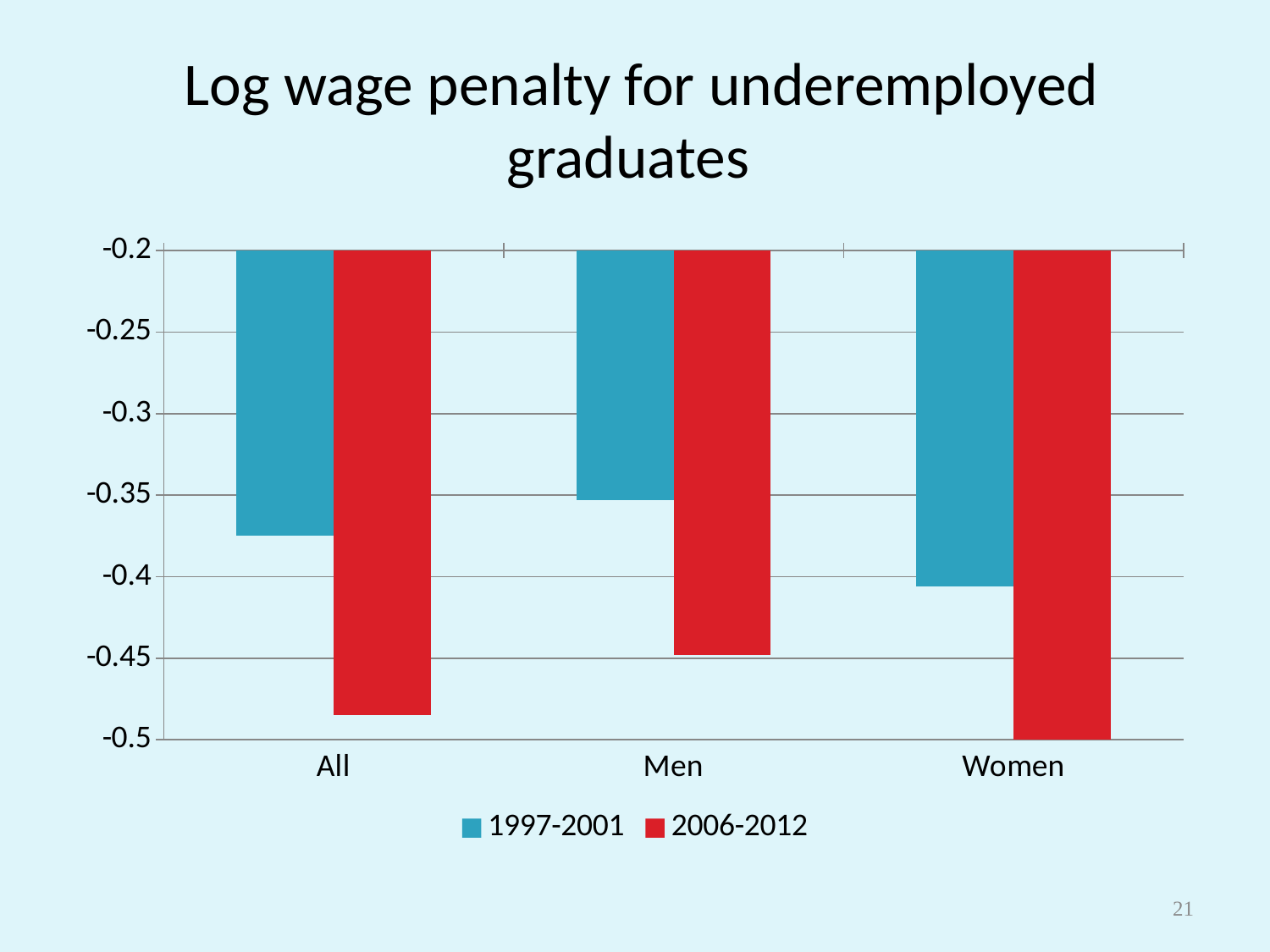
Which category has the lowest (most negative) value for the 2006-2012 series? Women Is the value for All in the 2006-2012 series greater or less than -0.45? less For Women, which series has the lower (more negative) value, 1997-2001 or 2006-2012? 2006-2012 For All, which series has the higher (less negative) value, 1997-2001 or 2006-2012? 1997-2001 How many series does the legend list? 2 Which category has the highest (least negative) value for the 2006-2012 series? Men How many categories are shown on the x axis? 3 What is the title of the chart? Log wage penalty for underemployed graduates Which category has the highest (least negative) value for the 1997-2001 series? Men What kind of chart is shown on the slide? bar chart Which colour represents the 2006-2012 series? red Is the value for Women in the 1997-2001 series greater or less than -0.45? greater